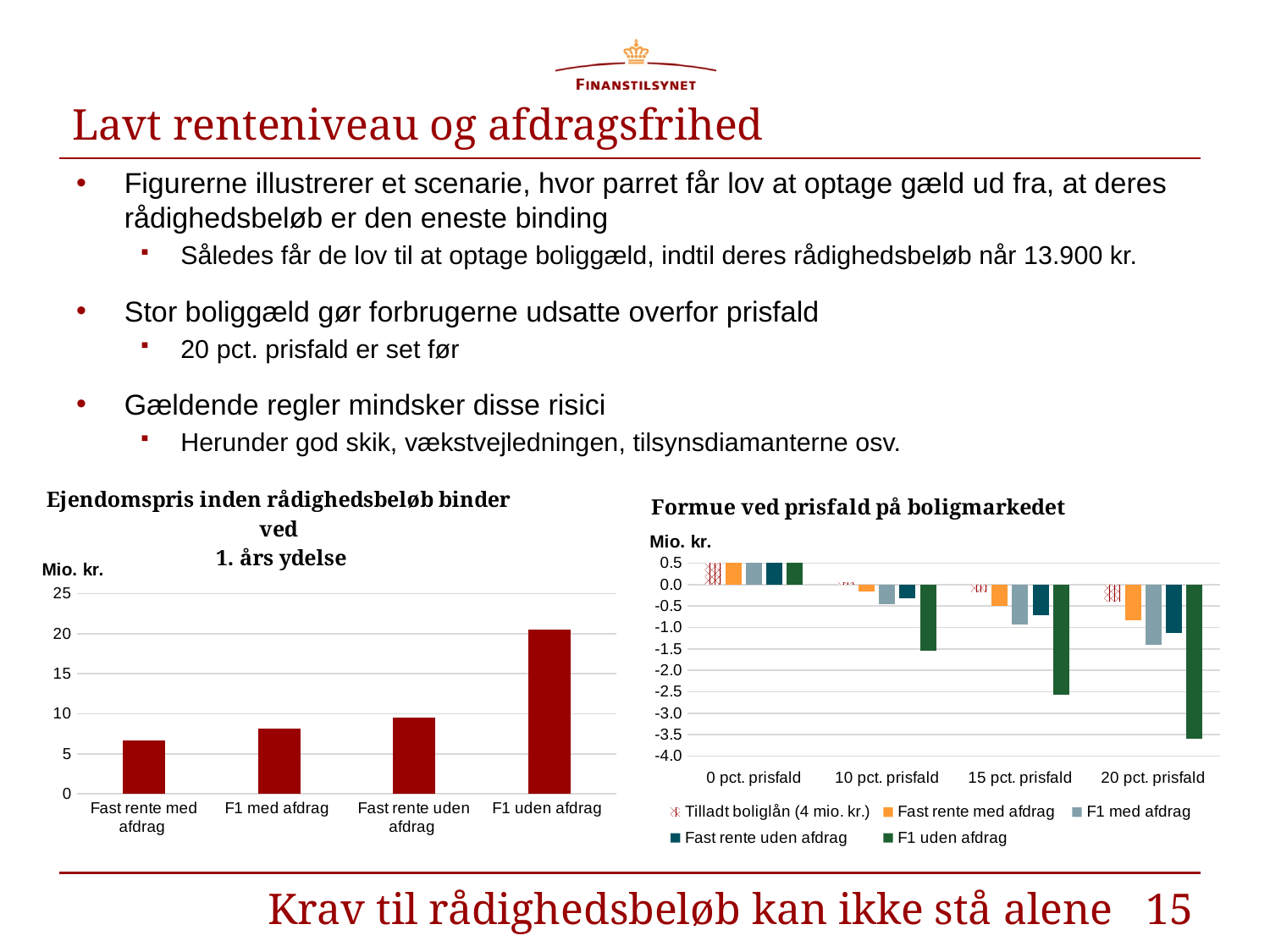
What kind of chart is 'Ejendomspris inden rådighedsbeløb binder ved 1. års ydelse'? Bar chart In the chart 'Formue ved prisfald på boligmarkedet', which series has the lowest value at 20 pct. prisfald? F1 uden afdrag In the chart 'Ejendomspris inden rådighedsbeløb binder ved 1. års ydelse', which category has the lowest value? Fast rente med afdrag In the chart 'Formue ved prisfald på boligmarkedet', is the value for F1 uden afdrag at 10 pct. prisfald greater or less than -1.0? less In the chart 'Ejendomspris inden rådighedsbeløb binder ved 1. års ydelse', what unit is shown on the axis label? Mio. kr. In the chart 'Ejendomspris inden rådighedsbeløb binder ved 1. års ydelse', how many categories are shown on the x axis? 4 In the chart 'Ejendomspris inden rådighedsbeløb binder ved 1. års ydelse', which category has the highest value? F1 uden afdrag In the chart 'Formue ved prisfald på boligmarkedet', is the value for F1 uden afdrag at 20 pct. prisfald greater or less than -3.0? less In the chart 'Formue ved prisfald på boligmarkedet', how many series does the legend list? 5 In the chart 'Formue ved prisfald på boligmarkedet', do the values for F1 uden afdrag rise or fall as the price drop increases from 0 pct. to 20 pct. prisfald? fall